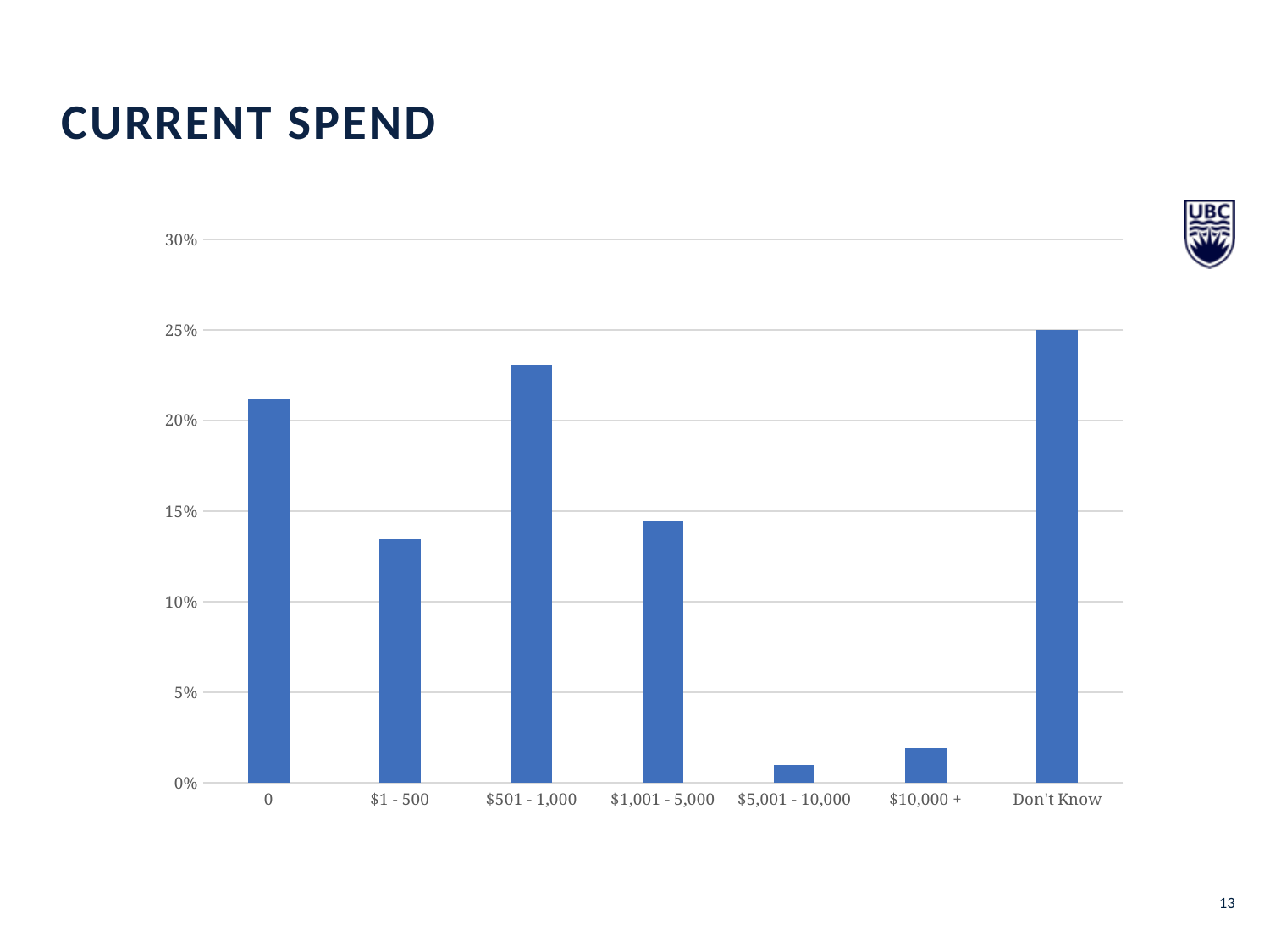
Which category has the highest bar in the chart? Don't Know Which is larger, the value for 0 or the value for $501 - 1,000? $501 - 1,000 Is the value for 0 greater or less than 20%? greater What type of chart is shown on the slide? Bar chart What is the value for Don't Know? 25% Which category has the lowest bar in the chart? $5,001 - 10,000 Is the value for $10,000 + greater or less than 5%? less Is the value for $1 - 500 greater or less than 15%? less How many categories are shown on the x axis of the chart? 7 What is the title of the slide containing the chart? CURRENT SPEND